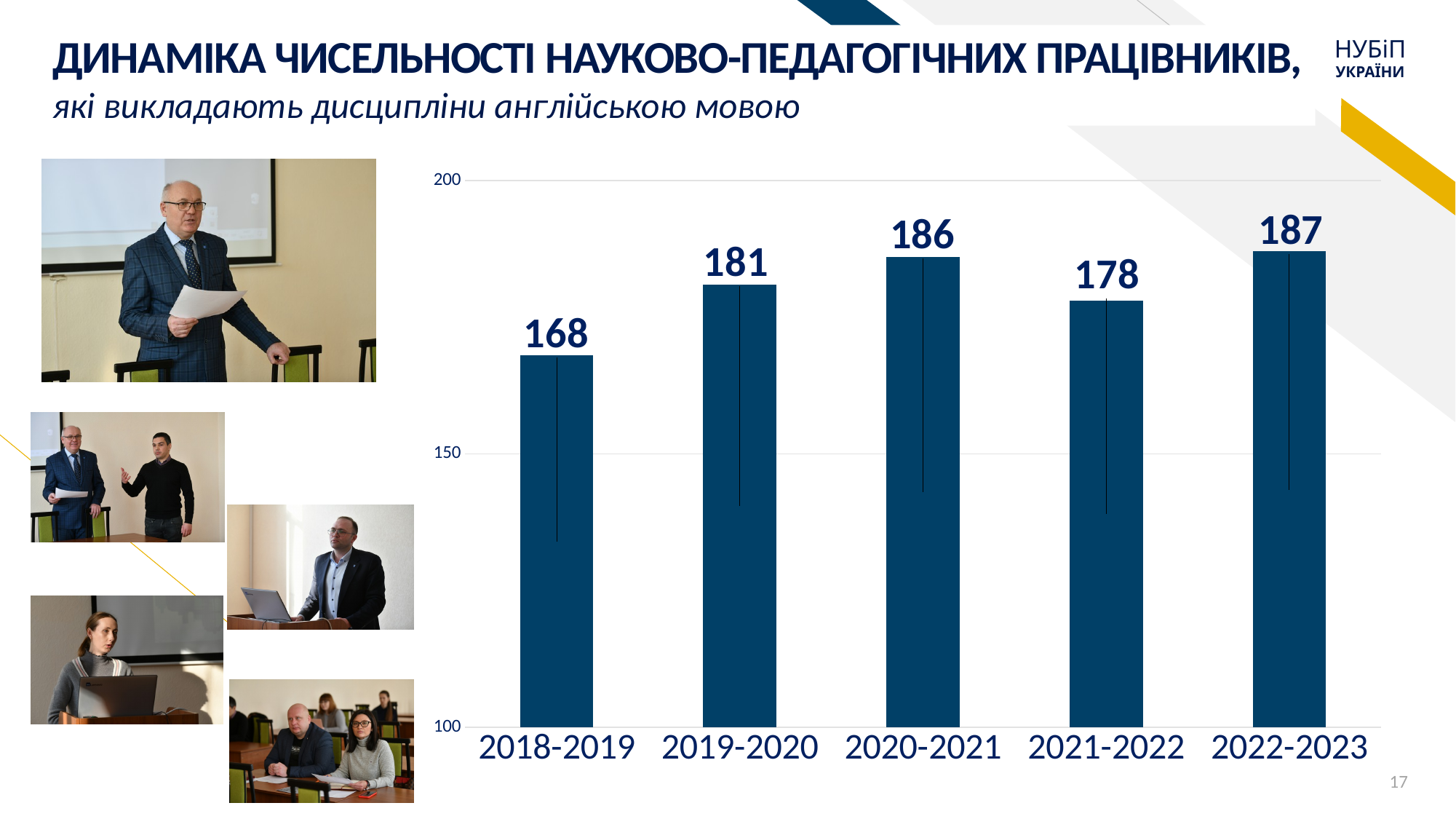
What is the value for 2020-2021? 186 What is the difference between the values for 2022-2023 and 2018-2019? 19 Is the value for 2019-2020 greater or less than 150? greater Which academic year has the lowest value? 2018-2019 Which academic year has the highest value? 2022-2023 What is the value for 2021-2022? 178 How many academic years are shown on the x axis? 5 Does the value rise or fall from 2020-2021 to 2021-2022? fall What is the difference between the values for 2020-2021 and 2021-2022? 8 Which is larger, the value for 2019-2020 or the value for 2021-2022? 2019-2020 What kind of chart is shown on the slide? bar chart What is the value for 2018-2019? 168